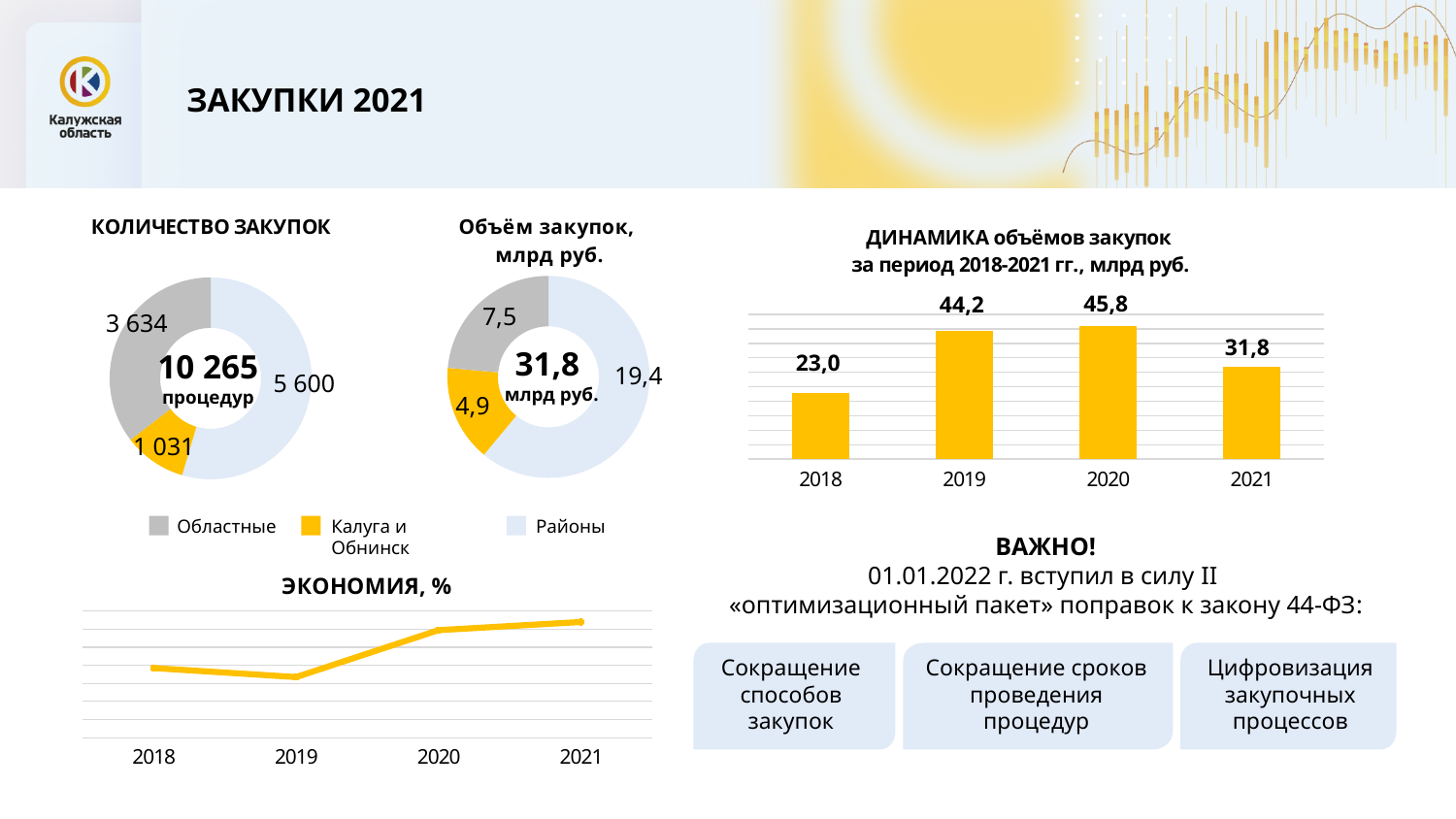
In the donut chart 'Объём закупок, млрд руб.', what is the value for Областные? 7,5 In the bar chart 'ДИНАМИКА объёмов закупок', which year has the highest value? 2020 In the bar chart 'ДИНАМИКА объёмов закупок', what is the difference between the values for 2020 and 2019? 1,6 In the donut chart 'КОЛИЧЕСТВО ЗАКУПОК', what is the difference between Районы and Областные? 1 966 What kind of chart is 'ЭКОНОМИЯ, %'? line chart In the donut chart 'КОЛИЧЕСТВО ЗАКУПОК', which category has the smallest value? Калуга и Обнинск In the bar chart 'ДИНАМИКА объёмов закупок', what is the value for 2019? 44,2 In the bar chart 'ДИНАМИКА объёмов закупок', how many years are shown? 4 In the line chart 'ЭКОНОМИЯ, %', does the value rise or fall from 2019 to 2021? rise In the bar chart 'ДИНАМИКА объёмов закупок', which year has the lowest value? 2018 In the donut chart 'КОЛИЧЕСТВО ЗАКУПОК', what is the value for Районы? 5 600 In the donut chart 'Объём закупок, млрд руб.', which is larger: Калуга и Обнинск or Районы? Районы